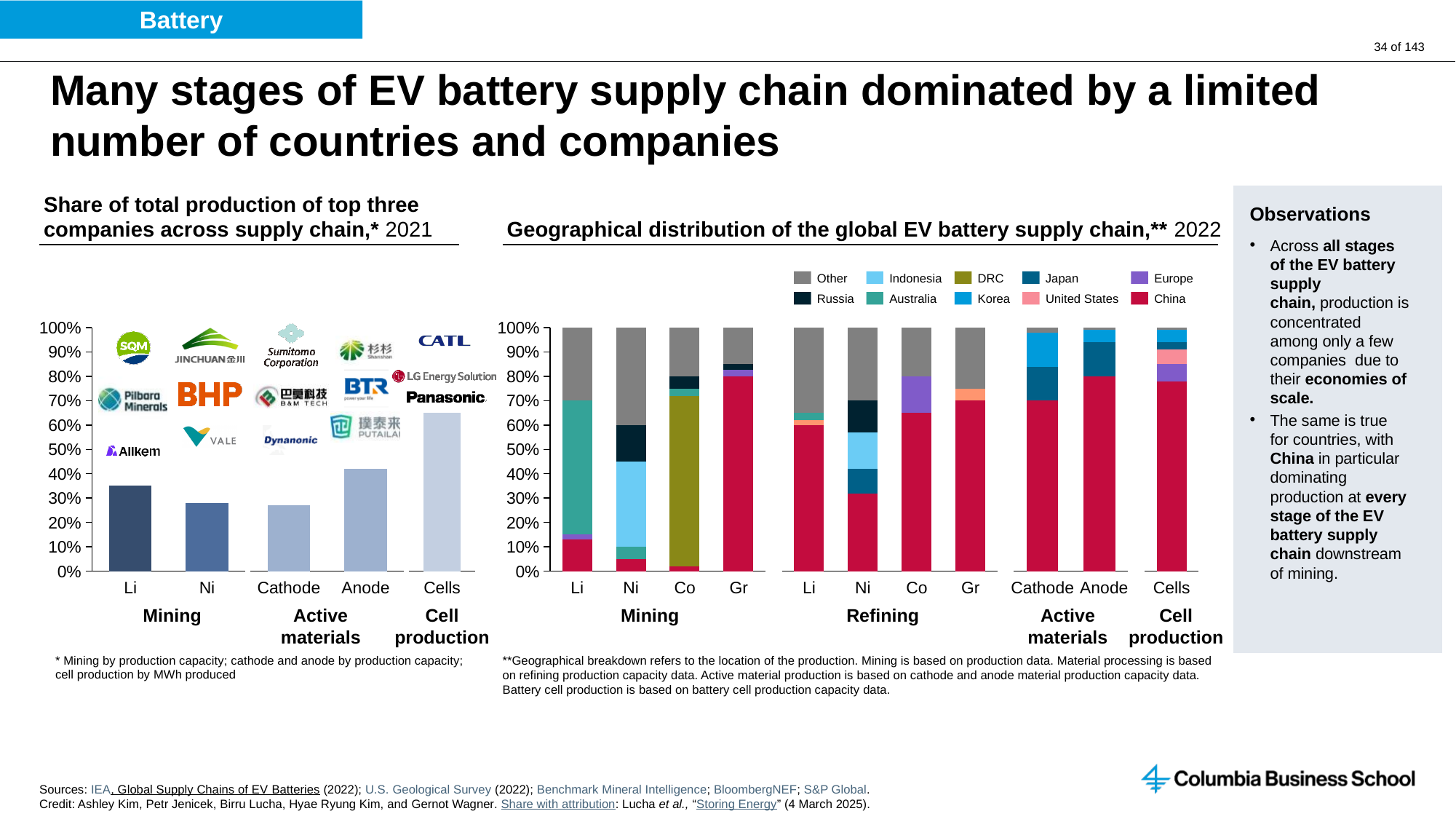
On the right chart (Geographical distribution of the global EV battery supply chain), which year does the title refer to? 2022 On the right chart (Geographical distribution of the global EV battery supply chain), is the China segment of the Li mining bar greater or less than 50%? less On the left chart (Share of total production of top three companies), which category has the highest value? Cells On the right chart (Geographical distribution of the global EV battery supply chain), is the China segment of the Gr mining bar greater or less than 70%? greater On the left chart (Share of total production of top three companies), how many categories are shown on the x axis? 5 On the left chart (Share of total production of top three companies), is the value for Cells greater or less than 60%? greater What kind of chart is the left chart (Share of total production of top three companies)? bar chart On the right chart (Geographical distribution of the global EV battery supply chain), how many entries does the legend list? 10 On the right chart (Geographical distribution of the global EV battery supply chain), how many bars are shown? 11 What kind of chart is the right chart (Geographical distribution of the global EV battery supply chain)? stacked bar chart On the left chart (Share of total production of top three companies), which is larger, the value for Li or the value for Anode? Anode